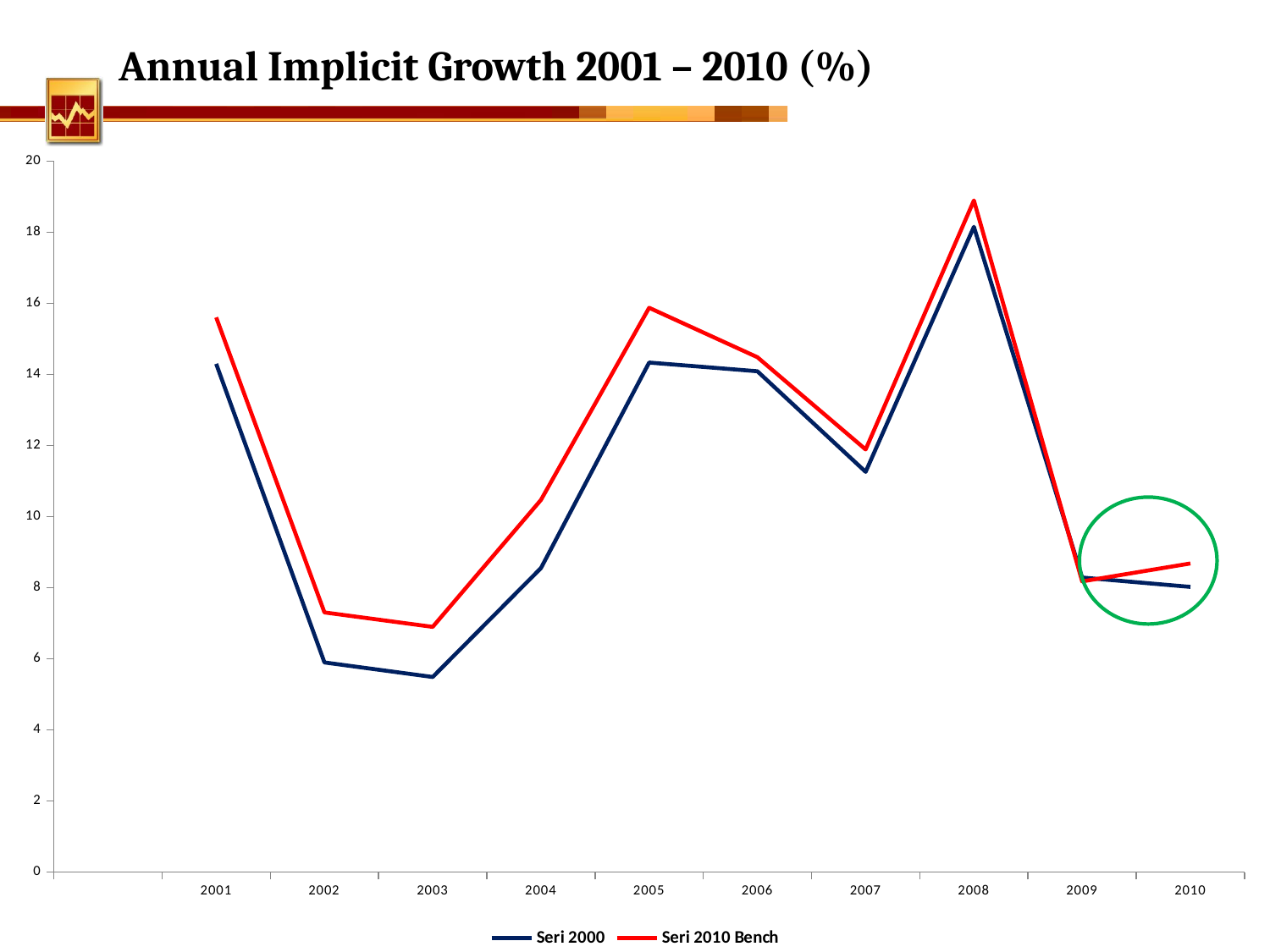
In which year does the Seri 2000 series reach its lowest value? 2003 Is the value for Seri 2010 Bench in 2008 greater or less than 18? greater What kind of chart is shown on the slide? line chart What is the title of the chart? Annual Implicit Growth 2001 – 2010 (%) Is the value for Seri 2010 Bench in 2002 greater or less than 8? less Is the value for Seri 2000 in 2007 greater or less than 12? less In 2005, which series has the higher value, Seri 2000 or Seri 2010 Bench? Seri 2010 Bench How many series does the legend list? 2 How many years are plotted along the x axis? 10 Do the values of the Seri 2000 series rise or fall from 2001 to 2003? fall In which year does the Seri 2010 Bench series reach its highest value? 2008